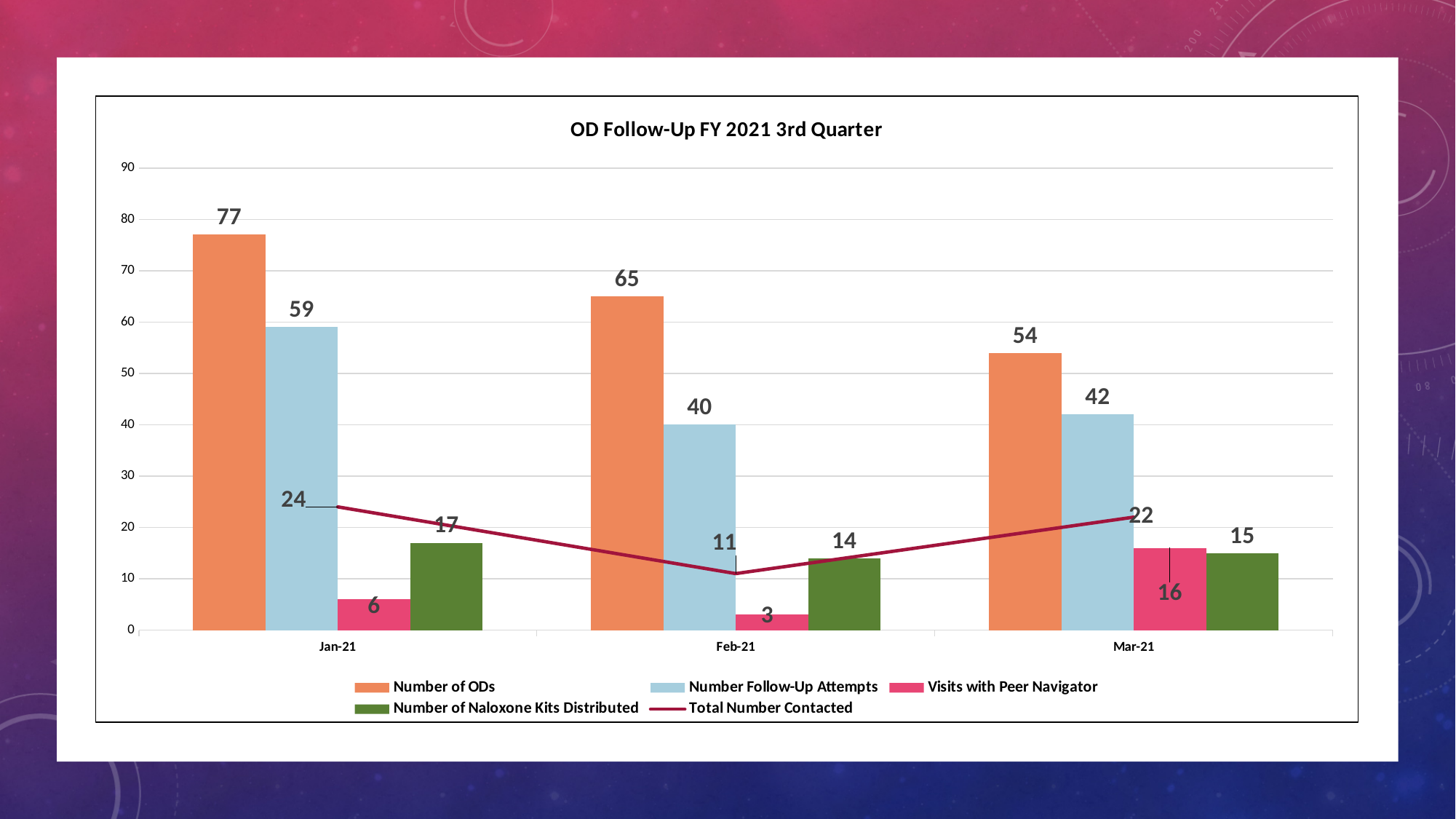
What is the difference between the Number of ODs in Jan-21 and Feb-21? 12 What is the Visits with Peer Navigator value for Mar-21? 16 What is the Total Number Contacted for Jan-21? 24 Which month has the lowest Visits with Peer Navigator value? Feb-21 What is the Number of ODs for Jan-21? 77 How many series does the legend list? 5 What kind of chart is this? Combined bar and line chart Does the Number of ODs rise or fall from Jan-21 to Mar-21? Fall Which month has the highest Number of ODs? Jan-21 Which is larger: Number of Naloxone Kits Distributed in Jan-21 or in Mar-21? Jan-21 How many months are shown on the x axis? 3 What is the Number Follow-Up Attempts value for Feb-21? 40